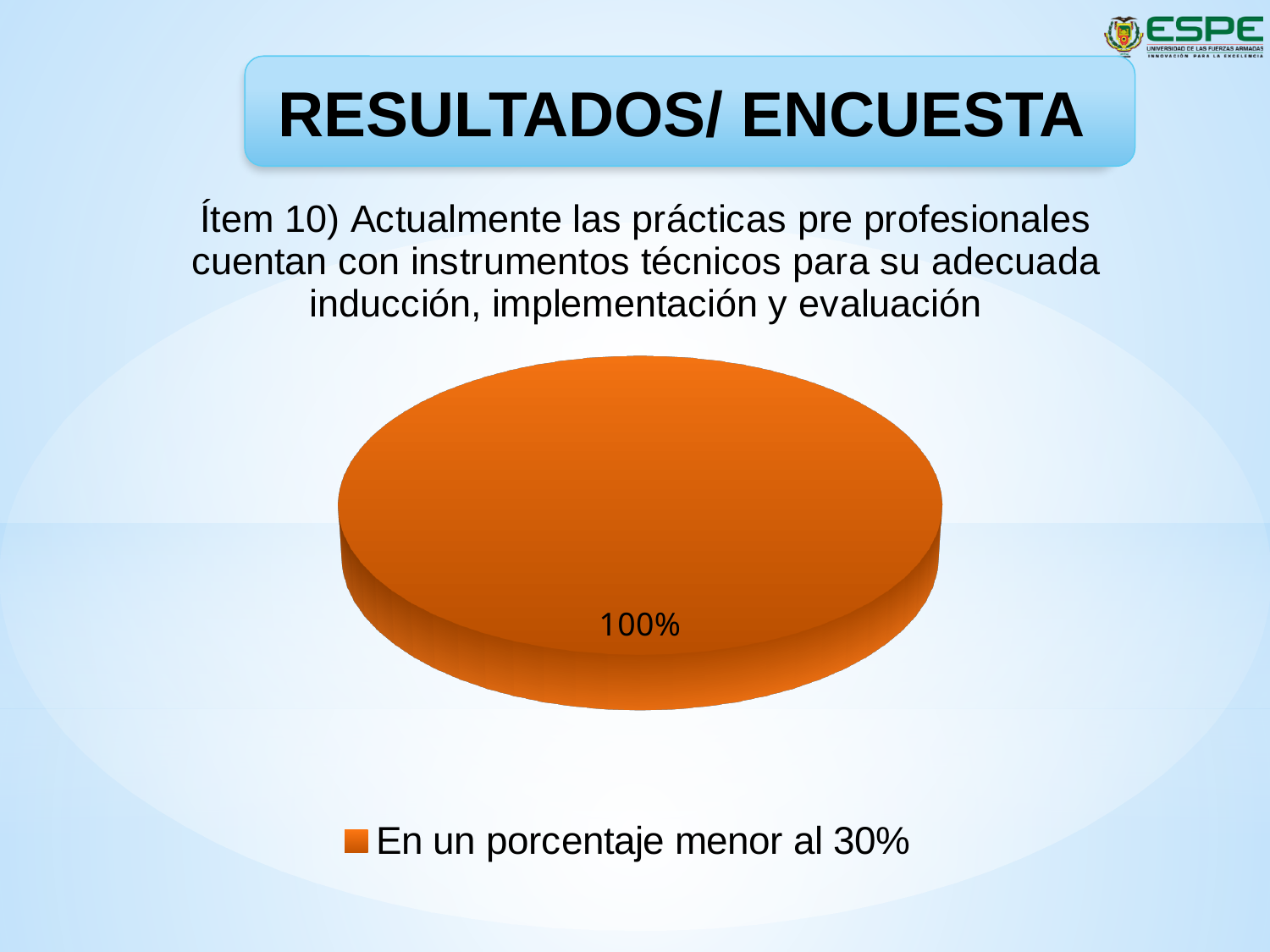
What is the value printed on the pie chart? 100% Is the value for "En un porcentaje menor al 30%" greater or less than 50%? greater What share of the pie does "En un porcentaje menor al 30%" represent? 100% How many slices does the pie chart have? 1 What colour is the pie slice? orange What kind of chart is shown on the slide? pie chart How many entries does the legend list? 1 What is the legend entry for the pie chart? En un porcentaje menor al 30%